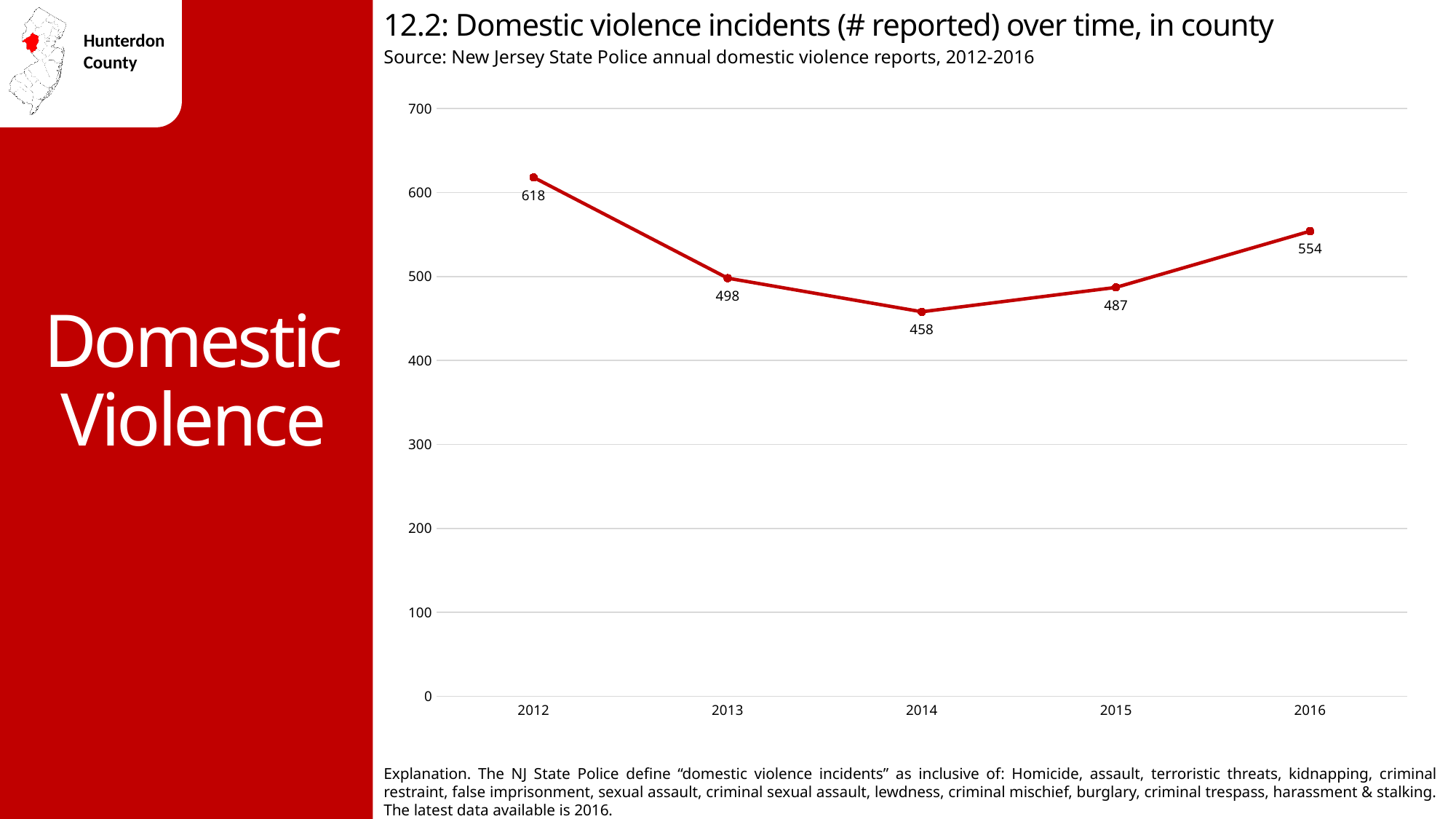
How many years are plotted on the chart? 5 Which year had the highest number of reported domestic violence incidents? 2012 How many domestic violence incidents were reported in 2012? 618 What is the difference between the number of incidents reported in 2012 and in 2014? 160 Which year had the lowest number of reported domestic violence incidents? 2014 Which year had more reported incidents, 2013 or 2015? 2013 Did the number of reported incidents rise or fall between 2012 and 2014? Fall By how much did reported incidents increase from 2015 to 2016? 67 Is the value for 2016 greater or less than 500? greater How many domestic violence incidents were reported in 2016? 554 What type of chart is shown on the slide? Line chart What was the number of reported domestic violence incidents in 2014? 458